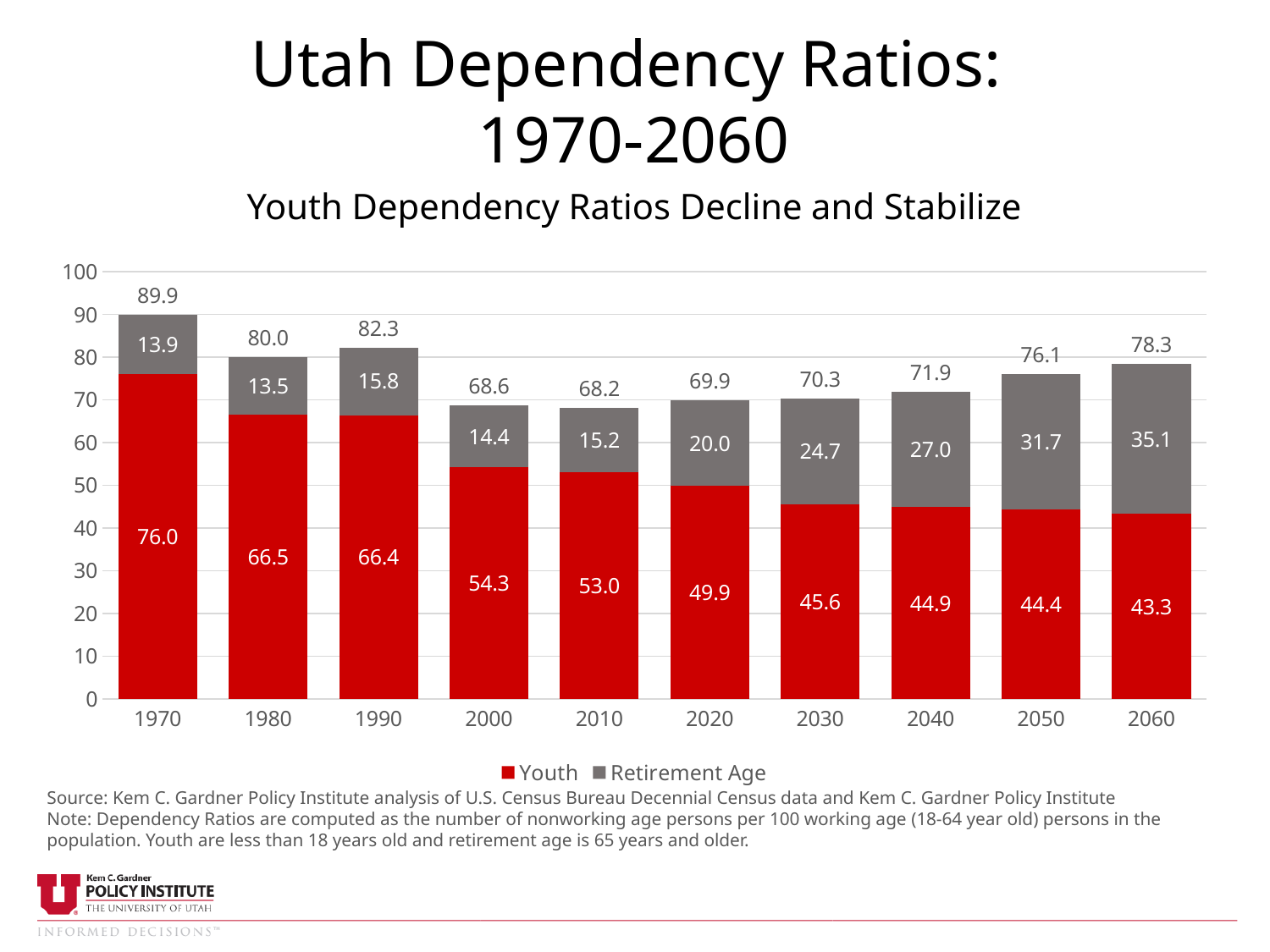
What is the difference between the Youth dependency ratio in 1970 and in 2060? 32.7 What kind of chart is shown? Stacked bar chart What is the total dependency ratio shown above the bar for 2000? 68.6 Which year has the lowest total dependency ratio? 2010 What is the Retirement Age dependency ratio for 2060? 35.1 What is the Youth dependency ratio for 1970? 76.0 Which year has the lowest Retirement Age dependency ratio? 1980 Does the Retirement Age dependency ratio rise or fall from 2000 to 2060? Rise How many years are shown on the x axis? 10 How many series does the legend list? 2 Which year has the highest Youth dependency ratio? 1970 Is the Youth dependency ratio larger in 2020 or in 2030? 2020